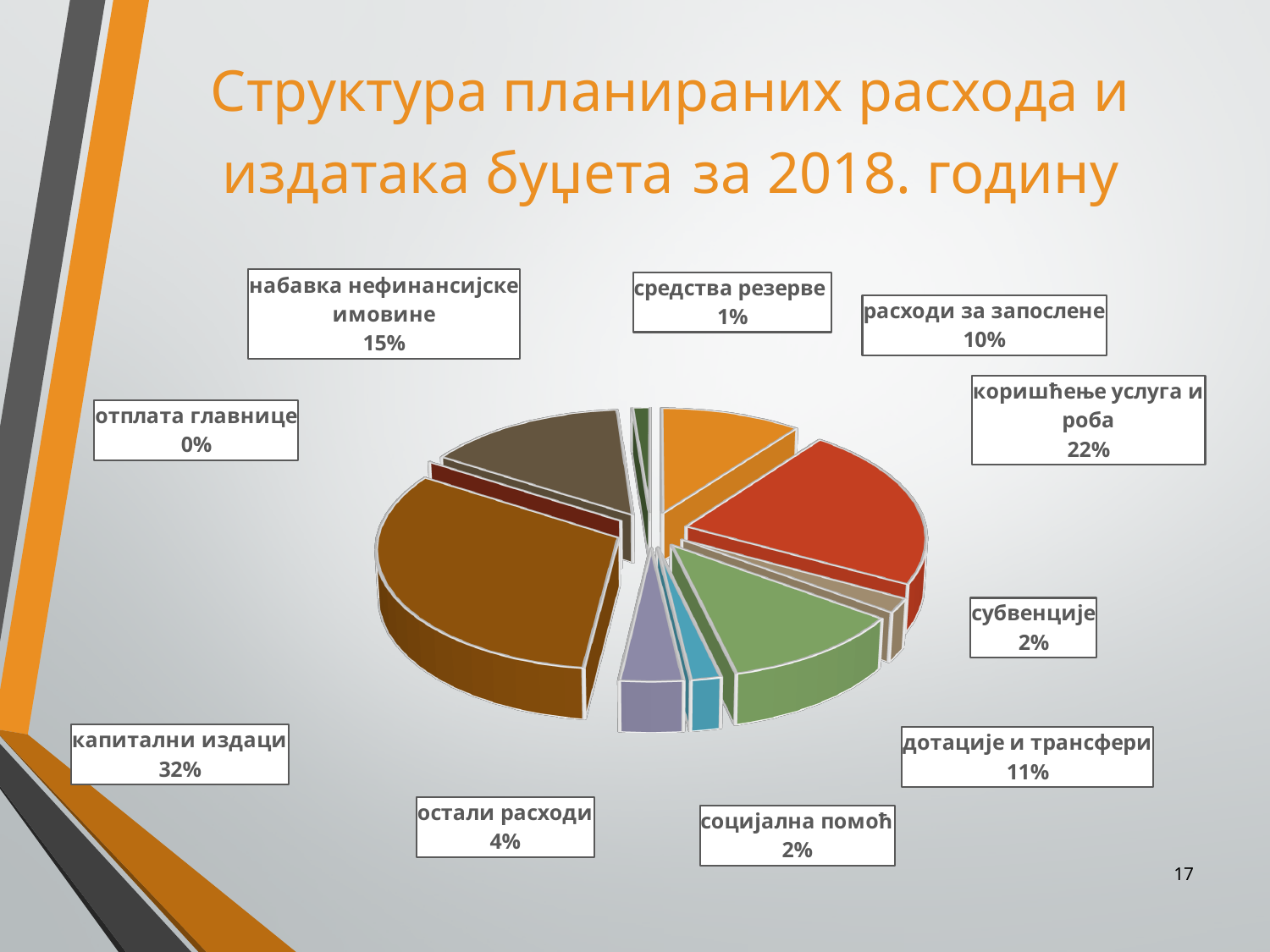
What is the difference between the shares of капитални издаци and коришћење услуга и роба? 10% What share of the pie does капитални издаци represent? 32% How many categories are shown in the pie chart? 10 Which is larger, расходи за запослене or дотације и трансфери? дотације и трансфери Which category has the largest share of the pie? капитални издаци What is the value shown for средства резерве? 1% What percentage is shown for набавка нефинансијске имовине? 15% What kind of chart is shown on the slide? pie chart What is the value shown for коришћење услуга и роба? 22% What is the value for дотације и трансфери? 11% What is the title of the slide containing the chart? Структура планираних расхода и издатака буџета за 2018. годину Which category has the smallest share of the pie? отплата главнице